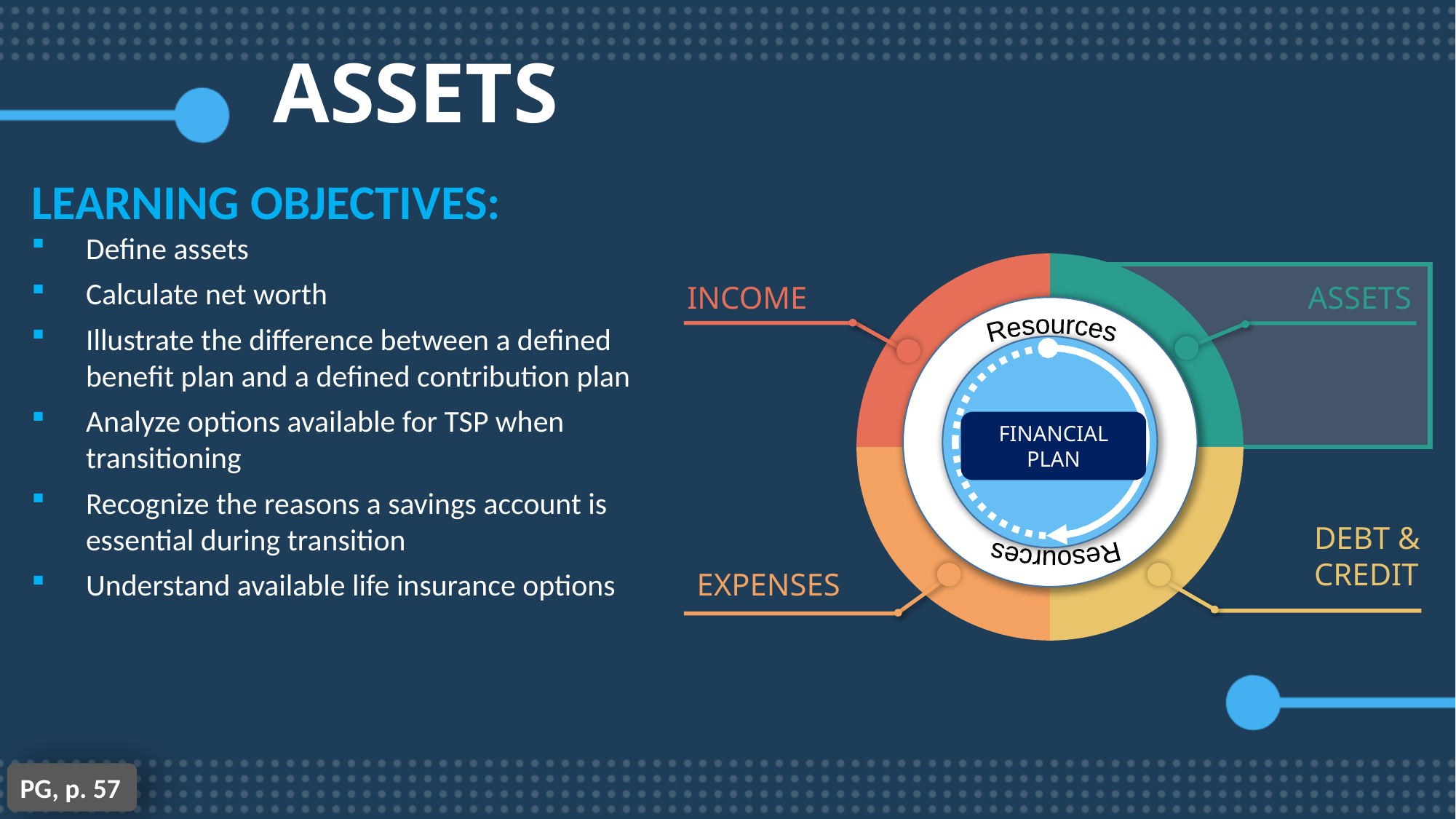
What label is attached to the red (top-left) segment of the ring diagram? INCOME What label is attached to the yellow (bottom-right) segment of the ring diagram? DEBT & CREDIT How many segments does the ring diagram on the right of the slide have? 4 What label is attached to the orange (bottom-left) segment of the ring diagram? EXPENSES Which segment of the ring diagram is highlighted with a box on this slide? ASSETS What text appears in the centre of the ring diagram? FINANCIAL PLAN